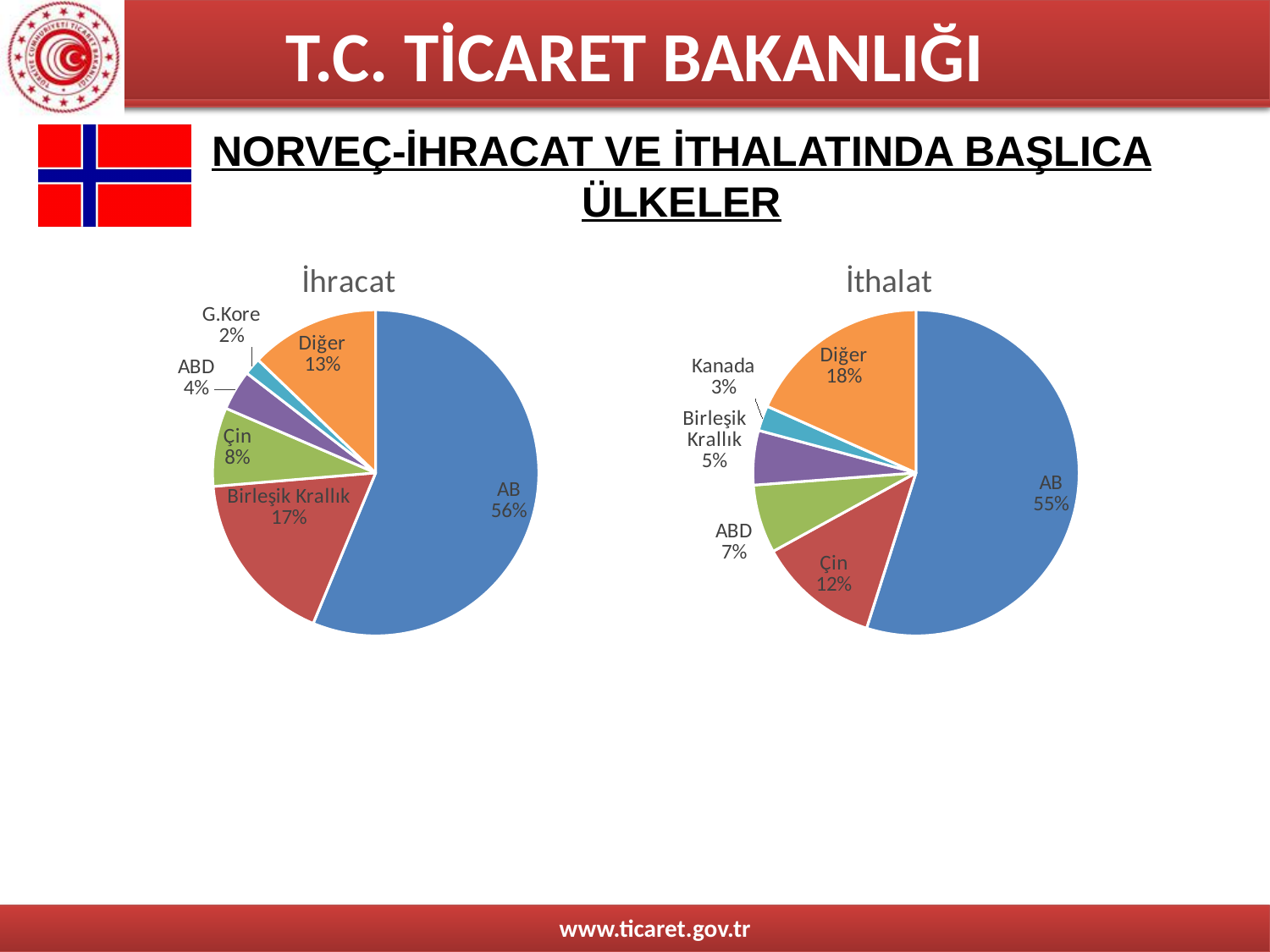
In the İhracat chart, what is the difference between the shares of Diğer and ABD? 9% How many slices does the İhracat chart have? 6 In the İthalat chart, what share does Çin have? 12% What is the title of the chart on the right? İthalat How many slices does the İthalat chart have? 6 In the İhracat chart, which category has the smallest share? G.Kore In the İthalat chart, which is larger, the share of ABD or the share of Birleşik Krallık? ABD What kind of chart is the İhracat chart? Pie chart In the İthalat chart, what share does Kanada have? 3% In the İhracat chart, what share does AB have? 56% In the İthalat chart, which category has the largest share? AB In the İhracat chart, what is the difference between the shares of Birleşik Krallık and Çin? 9%